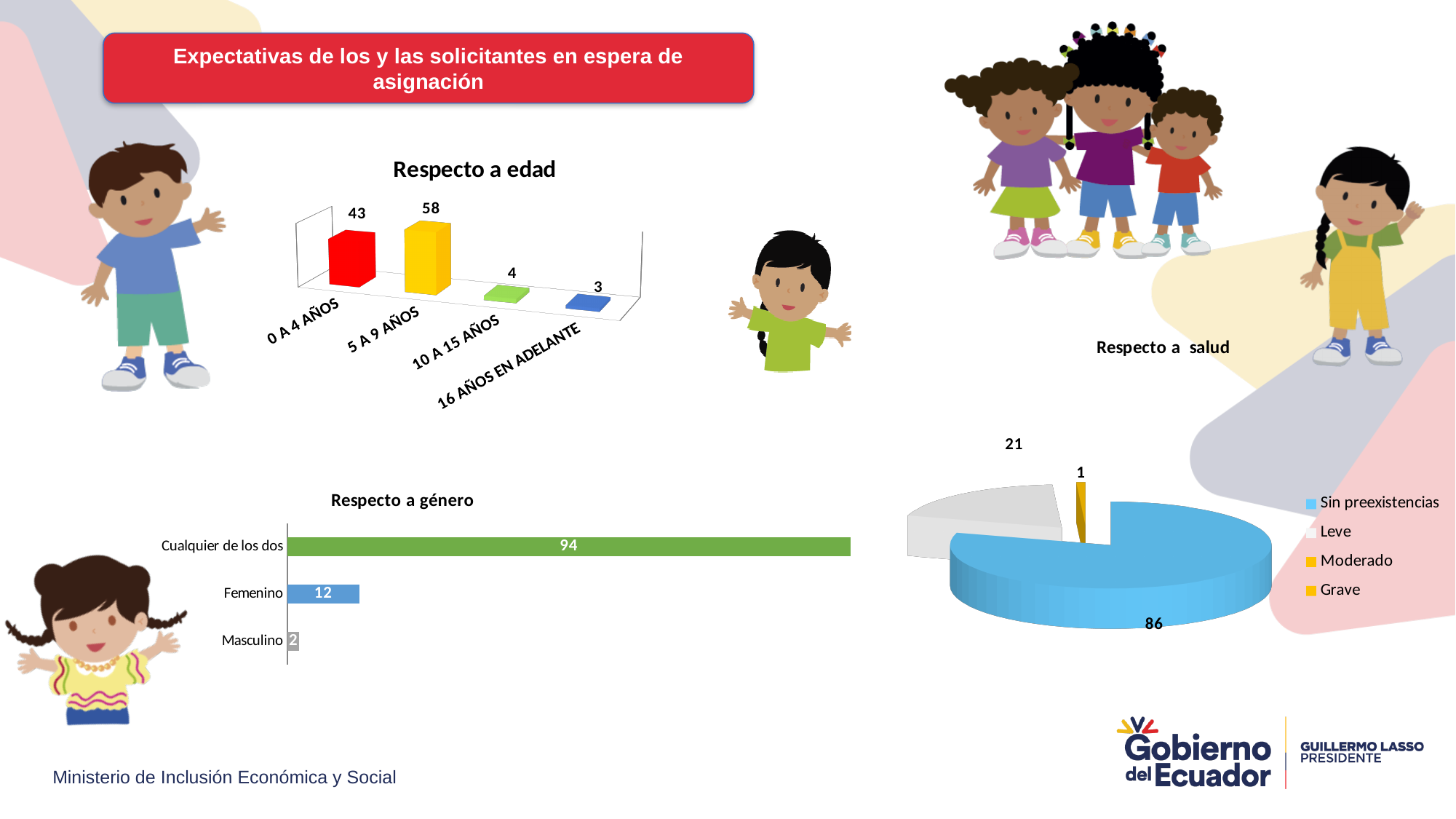
How many entries does the legend of the 'Respecto a salud' chart list? 4 In the 'Respecto a género' chart, which category has the highest value? Cualquier de los dos In the 'Respecto a edad' chart, which age group has the highest value? 5 A 9 AÑOS In the 'Respecto a edad' chart, which age group has the lowest value? 16 AÑOS EN ADELANTE In the 'Respecto a género' chart, what is the difference between Cualquier de los dos and Masculino? 92 In the 'Respecto a género' chart, what is the value for Femenino? 12 In the 'Respecto a salud' chart, what is the value for Leve? 21 In the 'Respecto a salud' chart, which is larger, Sin preexistencias or Leve? Sin preexistencias How many age categories are shown in the 'Respecto a edad' chart? 4 In the 'Respecto a edad' chart, what is the value for 5 A 9 AÑOS? 58 What kind of chart is 'Respecto a edad'? Bar chart In the 'Respecto a edad' chart, what is the difference between the values for 5 A 9 AÑOS and 0 A 4 AÑOS? 15